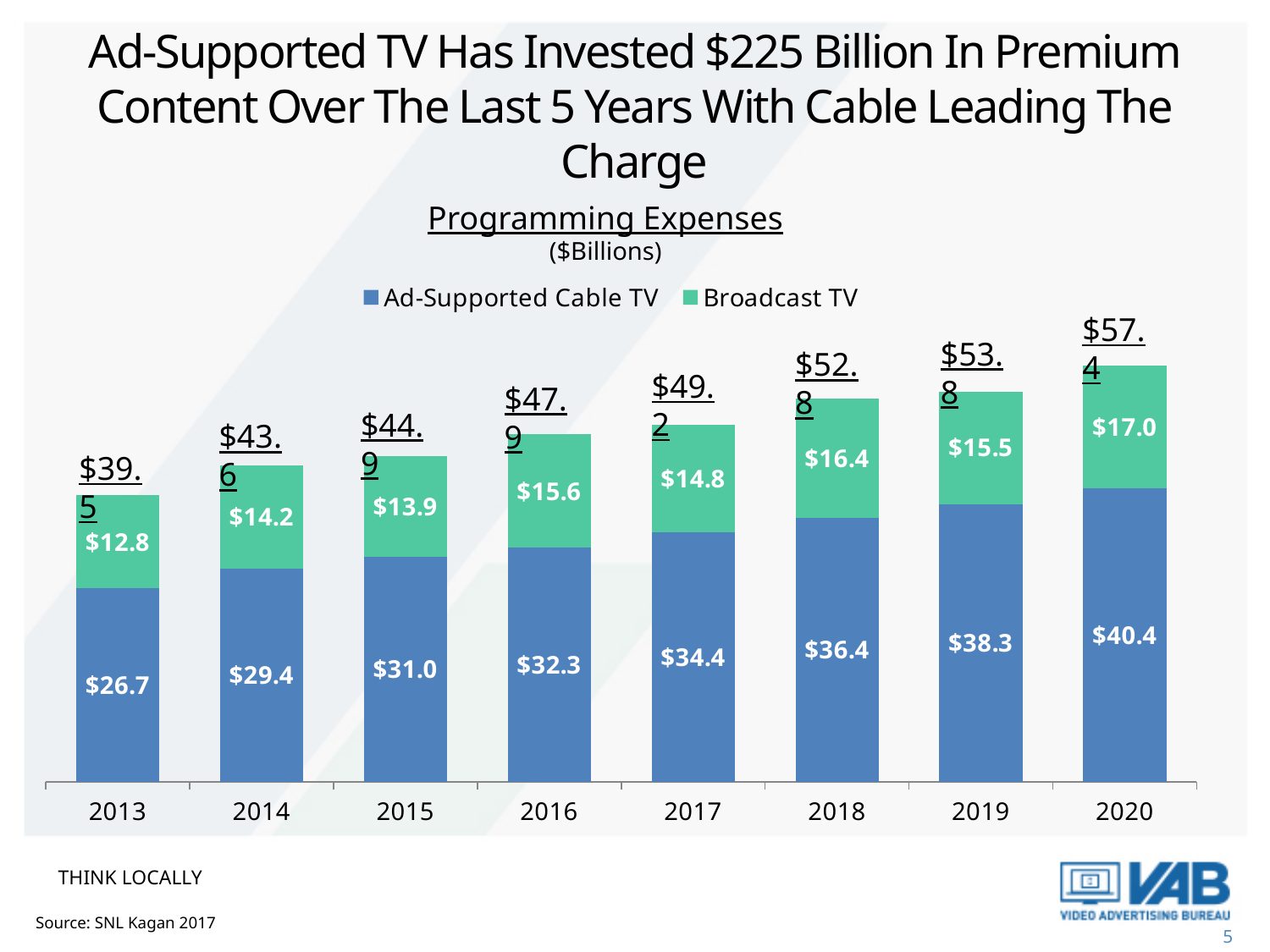
Do the total programming expenses rise or fall from 2013 to 2020? Rise Which year has the highest Ad-Supported Cable TV programming expense? 2020 What kind of chart is shown on the slide? Stacked bar chart What unit is given under the chart title 'Programming Expenses'? $Billions How many years are shown on the x axis? 8 What is the total programming expense shown above the bar for 2020? $57.4 What is the Broadcast TV programming expense for 2018? $16.4 Which year has the lowest Broadcast TV programming expense? 2013 How many series does the legend list? 2 Which is larger, the Broadcast TV expense in 2016 or in 2019? 2016 What is the difference between the Ad-Supported Cable TV expense in 2020 and in 2013? $13.7 What is the Ad-Supported Cable TV programming expense for 2016? $32.3